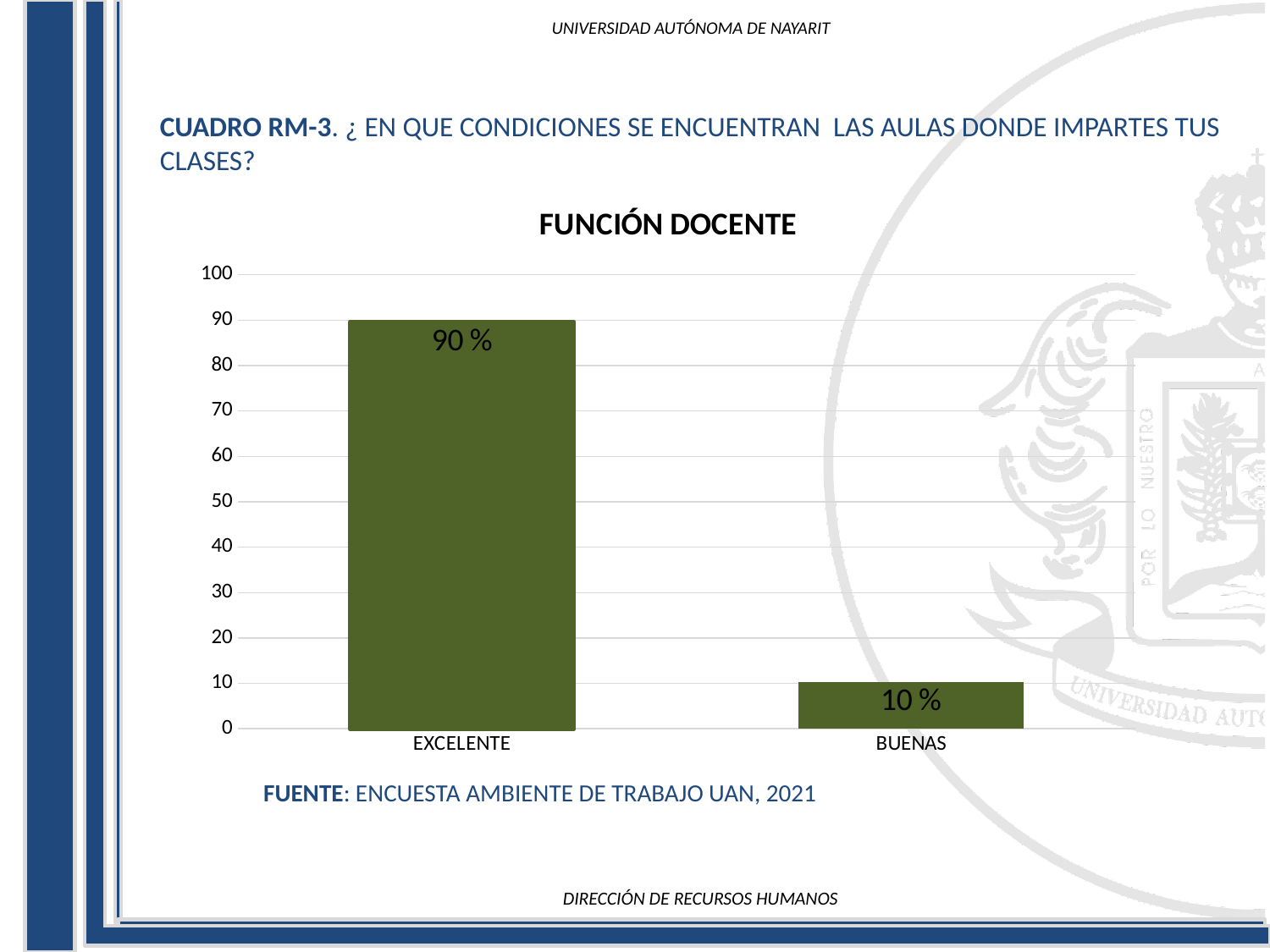
Which category has the highest value? EXCELENTE What is the title of the chart? FUNCIÓN DOCENTE What is the difference between the values for EXCELENTE and BUENAS? 80 % How many categories are shown on the x axis? 2 Is the value for EXCELENTE greater or less than 50? greater What is the value for BUENAS? 10 % Which is larger, the value for EXCELENTE or the value for BUENAS? EXCELENTE What kind of chart is shown? bar chart What is the highest value shown on the y axis? 100 Is the value for BUENAS greater or less than 20? less What is the value for EXCELENTE? 90 % Which category has the lowest value? BUENAS